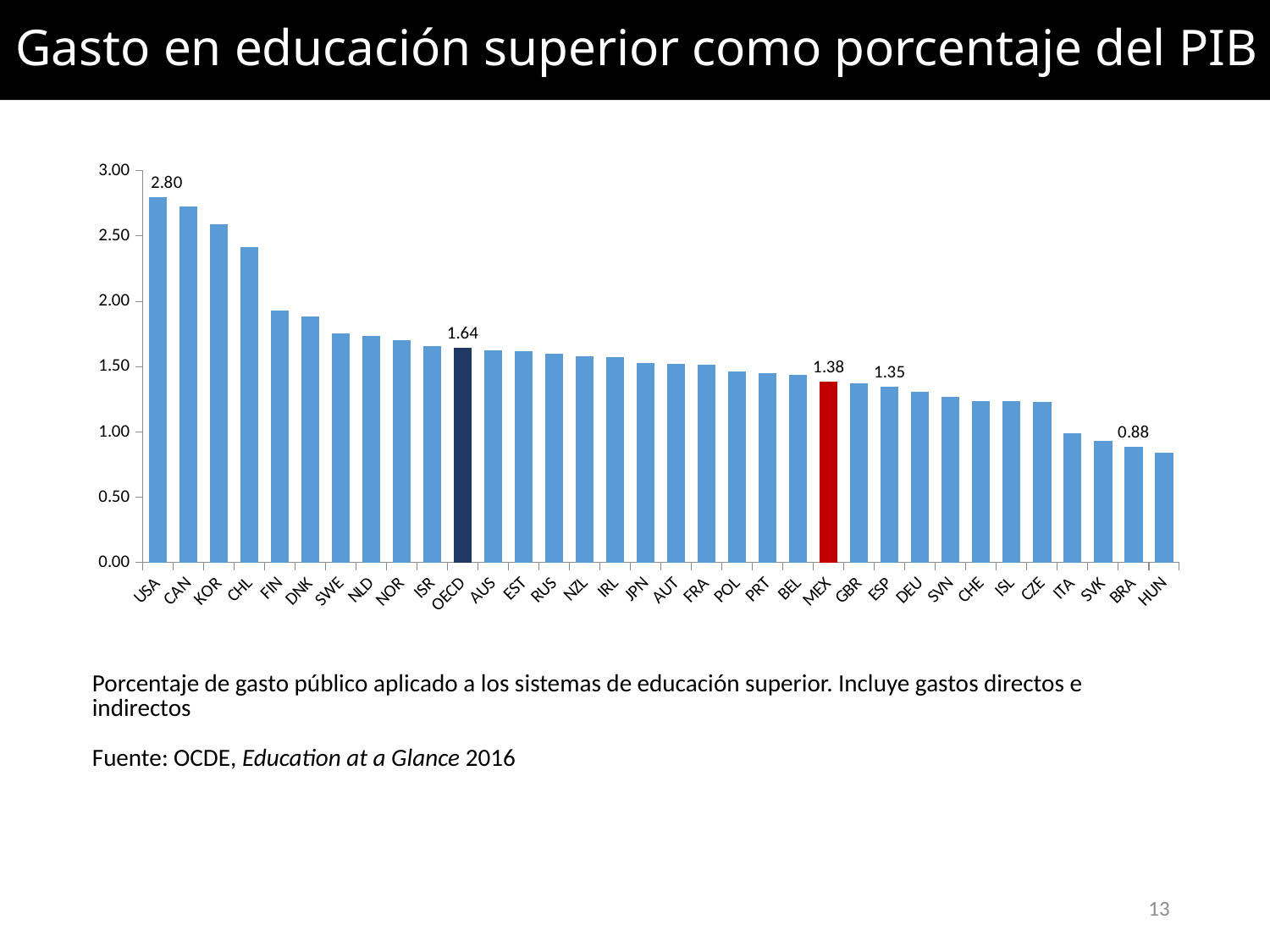
Which is larger, the value for MEX or the value for ESP? MEX What is the value for BRA? 0.88 What is the value for MEX? 1.38 Do the values rise or fall from left to right along the x axis? fall What is the value for OECD? 1.64 What colour is the bar for MEX? red What is the difference between the values for OECD and MEX? 0.26 Is the value for FIN greater or less than 2.00? less What is the value for USA? 2.80 Is the value for CAN greater or less than 2.50? greater What is the difference between the values for USA and OECD? 1.16 Which country has the highest value? USA